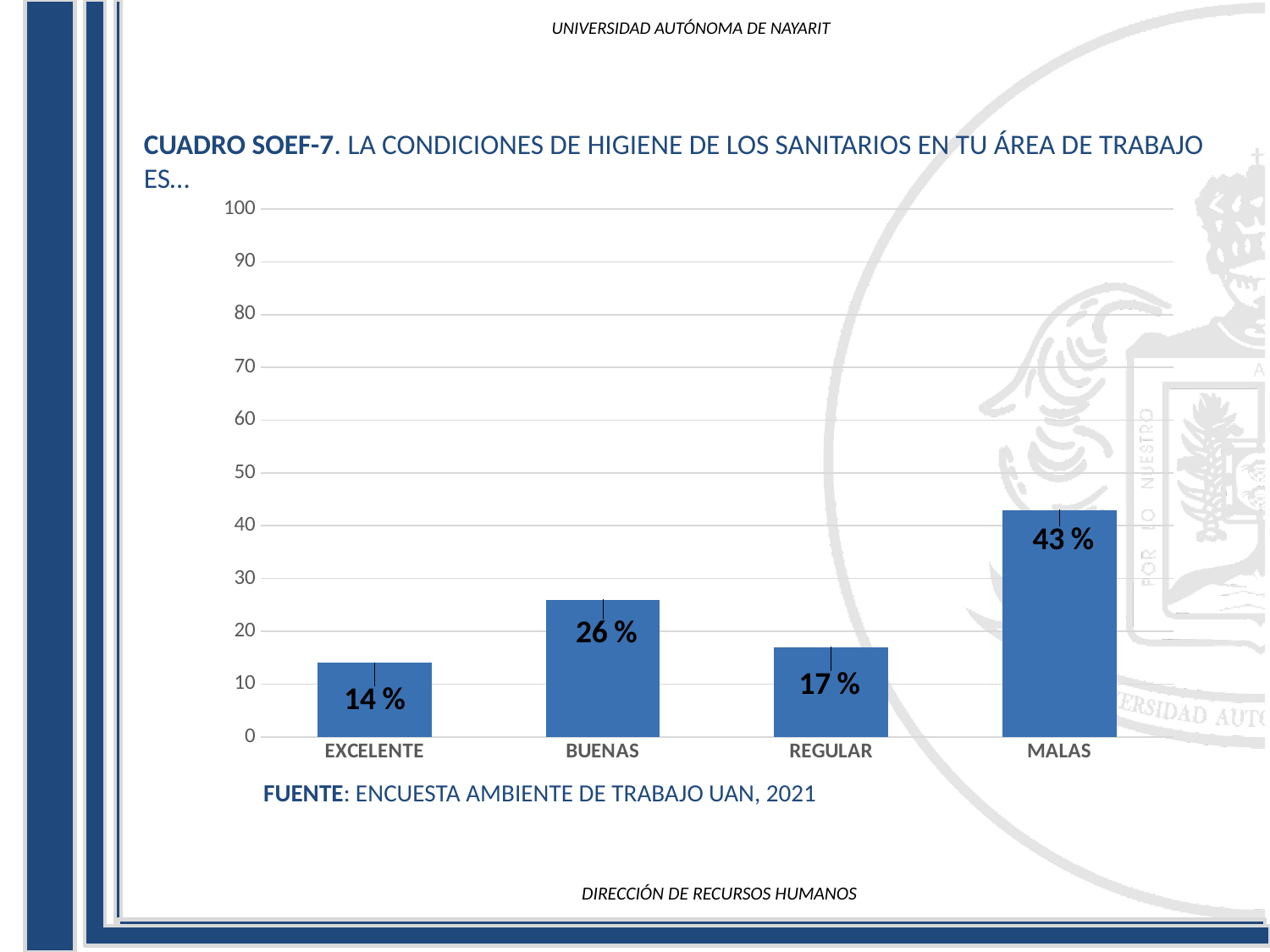
What kind of chart is shown on the slide? bar chart Which category has the lowest value? EXCELENTE Is the value for MALAS greater or less than 40? greater What is the source cited below the chart? ENCUESTA AMBIENTE DE TRABAJO UAN, 2021 What is the difference between the values for MALAS and BUENAS? 17 % Which category has the highest value? MALAS How many categories are shown on the x axis? 4 What is the value for REGULAR? 17 % What is the value for BUENAS? 26 % What is the value for MALAS? 43 % Which is larger, the value for BUENAS or the value for REGULAR? BUENAS What is the value for EXCELENTE? 14 %